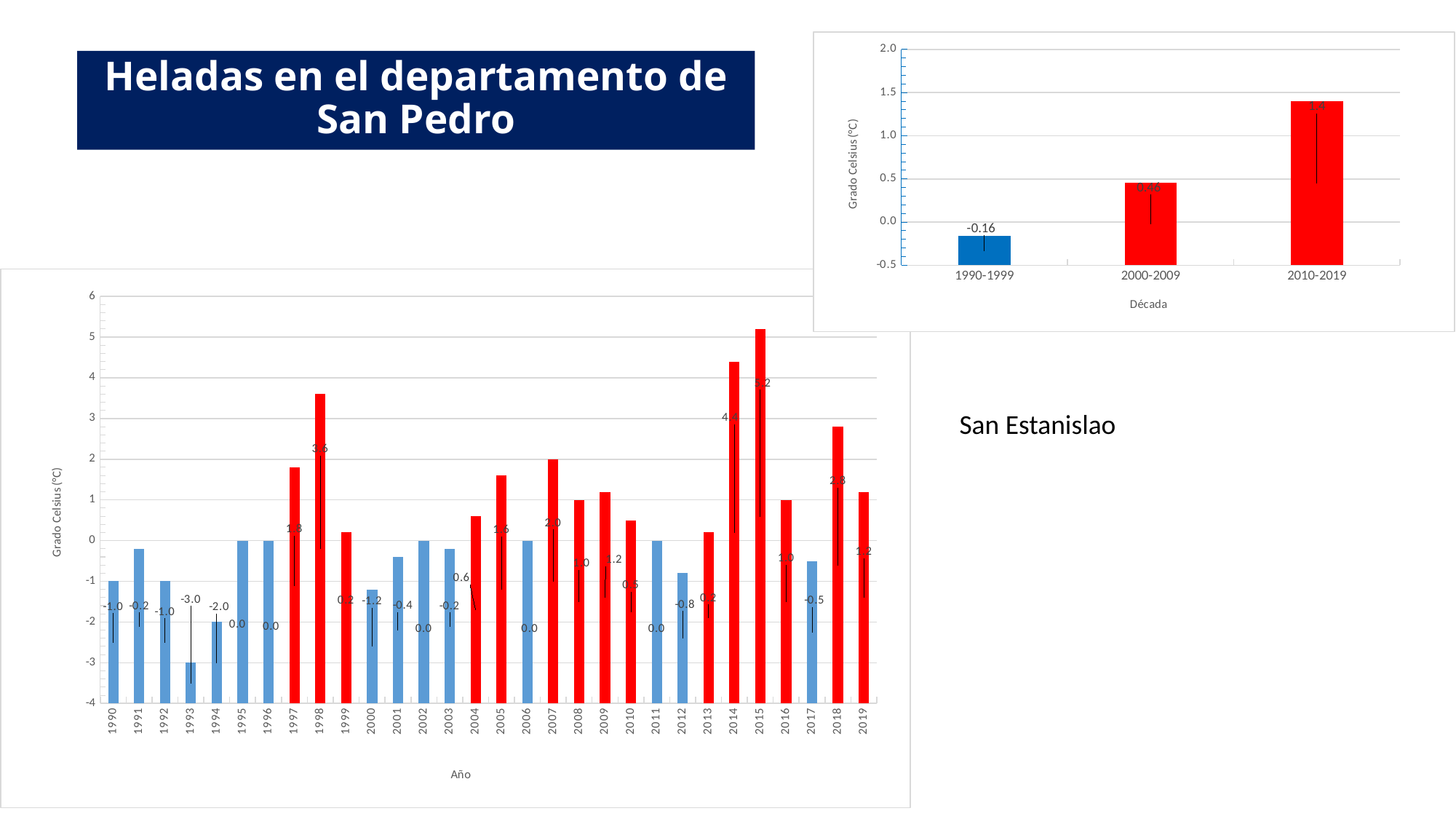
In the yearly chart on the left, what is the value for 1993? -3.0 In the yearly chart on the left, which year has the lowest value? 1993 In the decade chart at the top right, how many decades are shown on the x axis? 3 In the decade chart at the top right, what is the value for 2010-2019? 1.4 What kind of chart is the yearly chart on the left? bar chart In the decade chart at the top right, which decade has the highest value? 2010-2019 In the yearly chart on the left, what is the difference between the values for 2015 and 2014? 0.8 In the yearly chart on the left, which is larger, the value for 1998 or the value for 2018? 1998 In the yearly chart on the left, what is the value for 2015? 5.2 In the yearly chart on the left, which year has the highest value? 2015 In the decade chart at the top right, what is the value for 1990-1999? -0.16 In the decade chart at the top right, do the values rise or fall from 1990-1999 to 2010-2019? rise